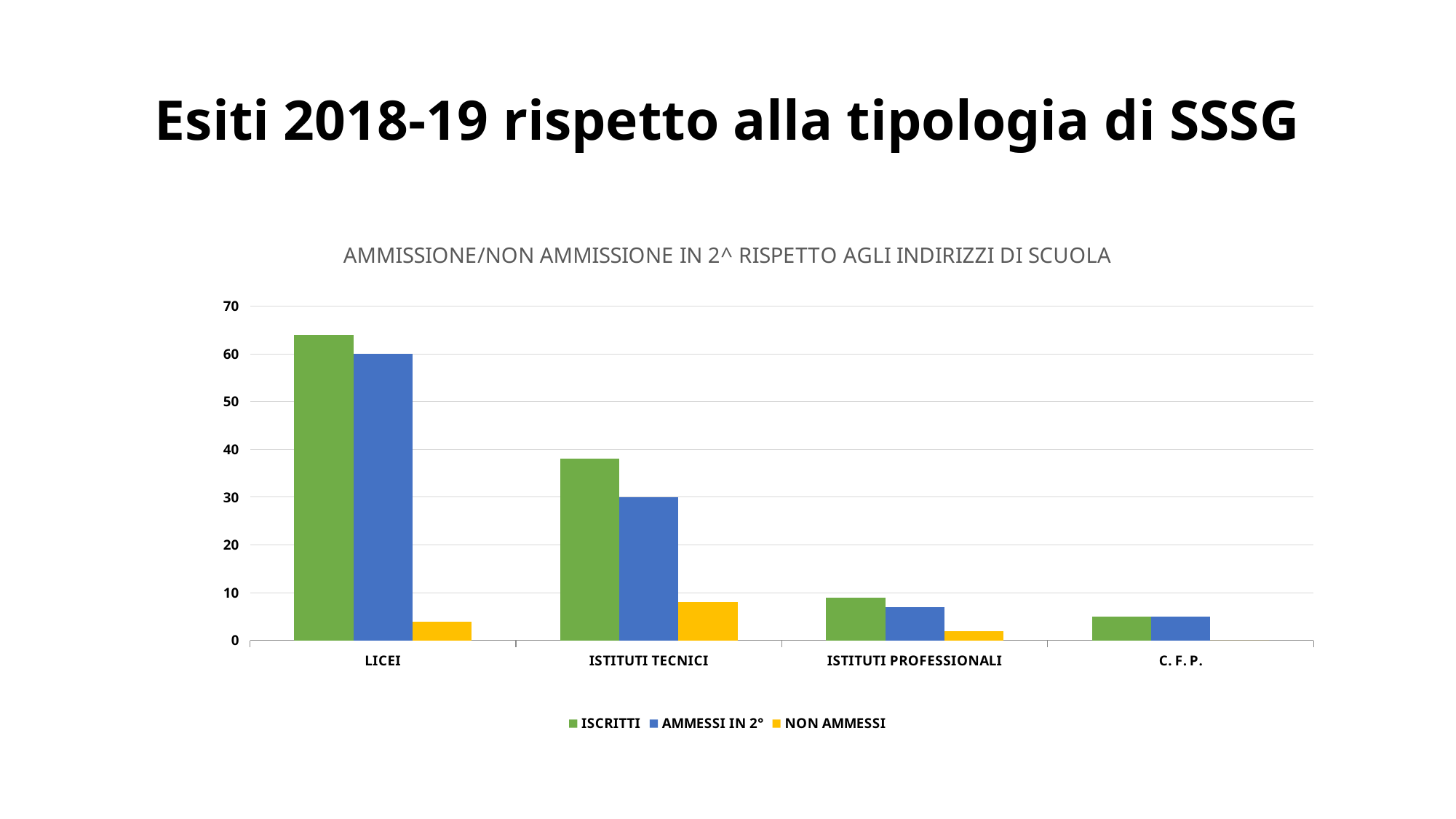
What is the AMMESSI IN 2° value for LICEI? 60 Is the ISCRITTI value for LICEI greater or less than 60? greater What is the AMMESSI IN 2° value for ISTITUTI TECNICI? 30 Which category has the lowest ISCRITTI value? C. F. P. Is the NON AMMESSI value for ISTITUTI TECNICI greater or less than 10? less What kind of chart is shown on the slide? Bar chart Do the ISCRITTI values rise or fall from LICEI to C. F. P. along the x axis? Fall Which category has the highest ISCRITTI value? LICEI Is the ISCRITTI value for ISTITUTI TECNICI greater or less than 40? less Which is larger, the ISCRITTI value for LICEI or the ISCRITTI value for ISTITUTI TECNICI? LICEI How many school types (categories) are shown on the x axis? 4 How many series does the legend list? 3